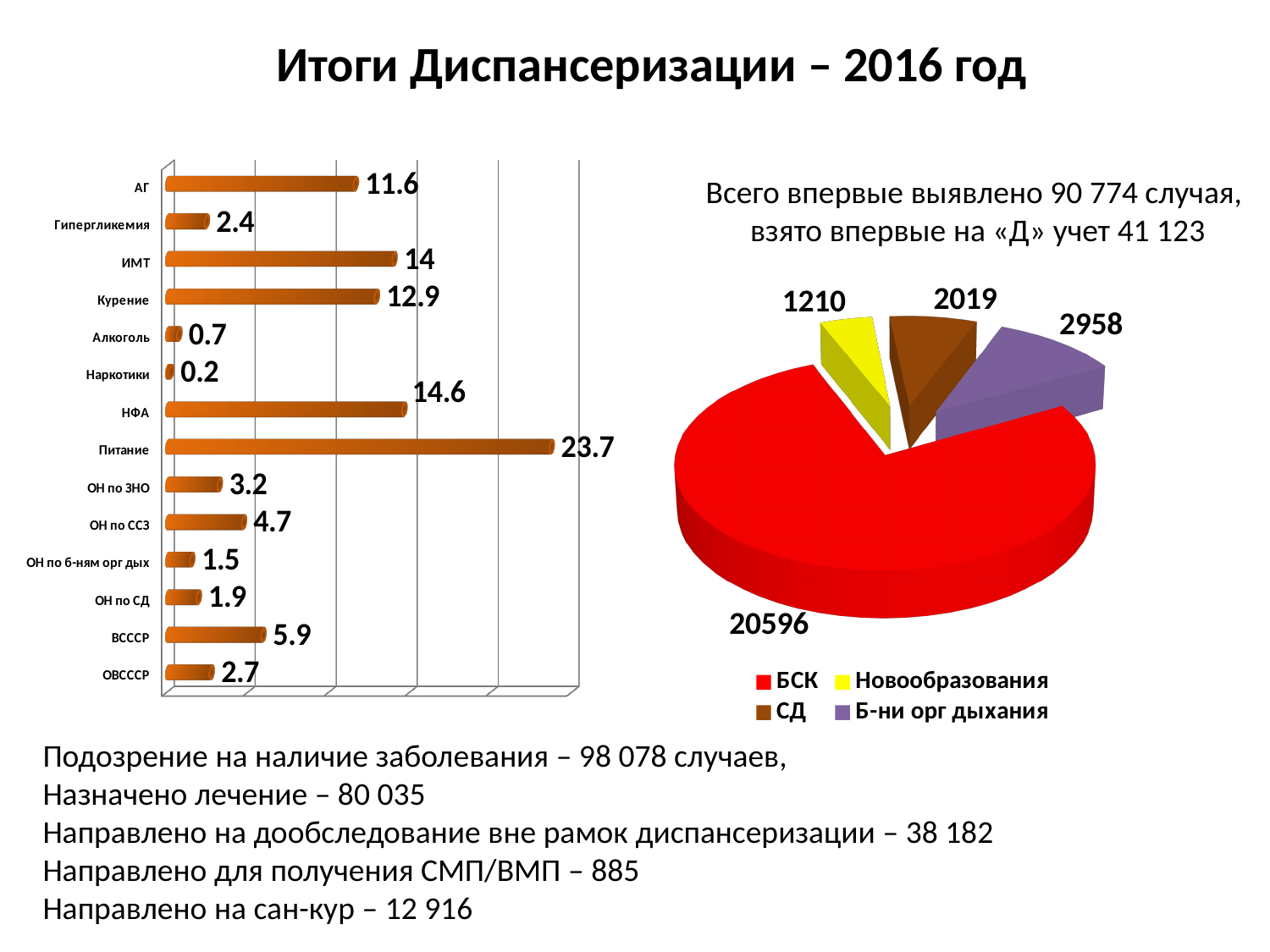
On the left bar chart, which category has the lowest value? Наркотики How many categories are shown on the left bar chart? 14 On the left bar chart, which is larger: the value for ВСССР or the value for ОН по ССЗ? ВСССР On the left bar chart, what is the difference between the values for НФА and ИМТ? 0.6 What kind of chart is the chart on the left of the slide? Bar chart On the left bar chart, which category has the highest value? Питание On the right pie chart, what is the difference between the values for СД and Новообразования? 809 How many entries does the legend of the right pie chart list? 4 On the left bar chart, what is the value for Питание? 23.7 On the left bar chart, what is the value for Курение? 12.9 On the right pie chart, which category has the largest slice? БСК On the right pie chart, what is the value for Б-ни орг дыхания? 2958